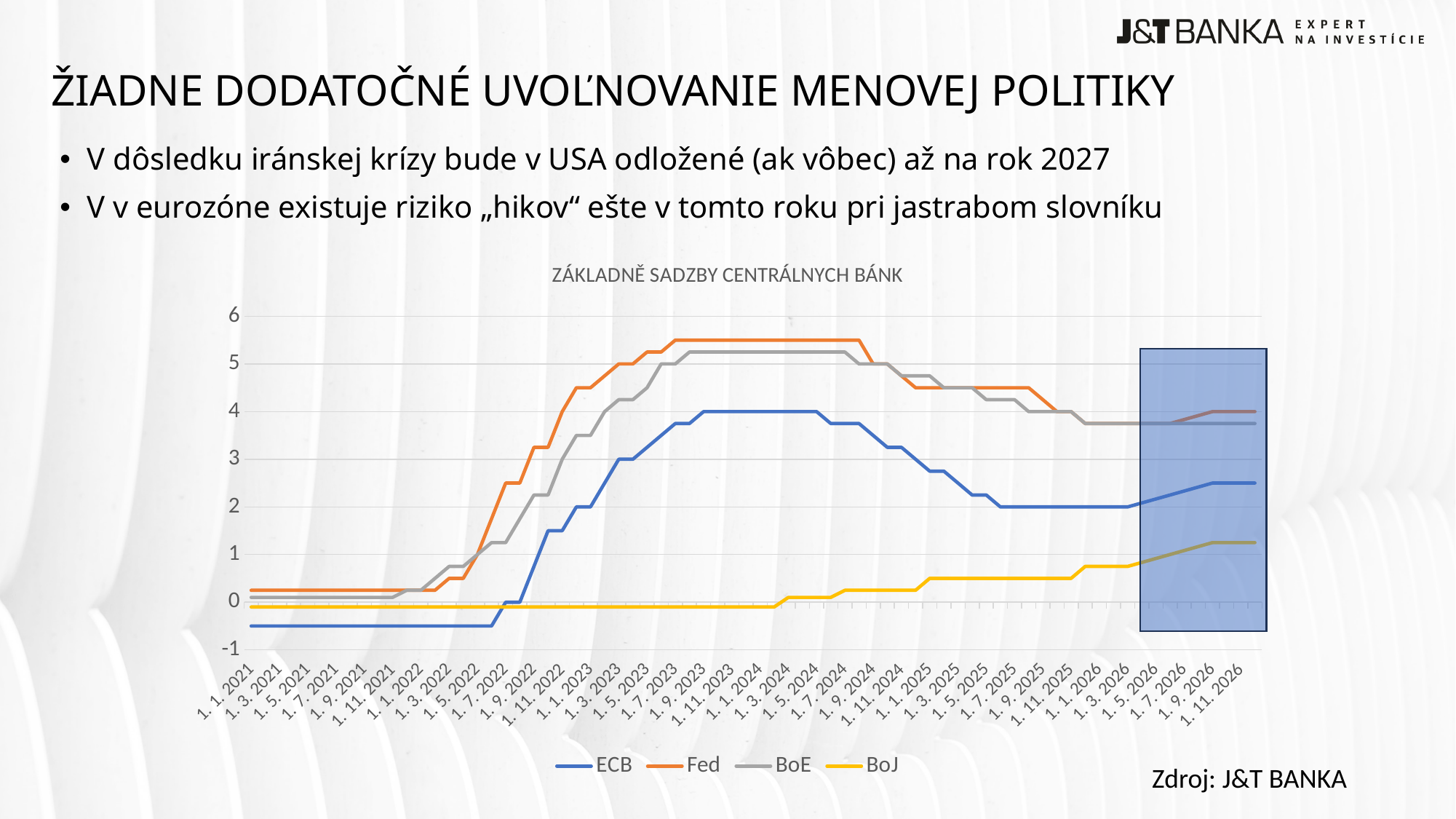
Is the value for ECB at 1. 11. 2026 greater or less than 2? greater Is the value for BoJ at 1. 1. 2024 greater or less than 1? less How many series does the legend list? 4 What is the title of the chart? ZÁKLADNĚ SADZBY CENTRÁLNYCH BÁNK Is the value for Fed at 1. 9. 2023 greater or less than 5? greater Which series has the highest value at 1. 9. 2023? Fed Does the Fed series rise or fall between 1. 9. 2024 and 1. 11. 2025? fall What kind of chart is shown on the slide? line chart Which series is drawn in orange? Fed Which series has the lowest value at 1. 11. 2026? BoJ At 1. 11. 2026, which is higher, Fed or ECB? Fed